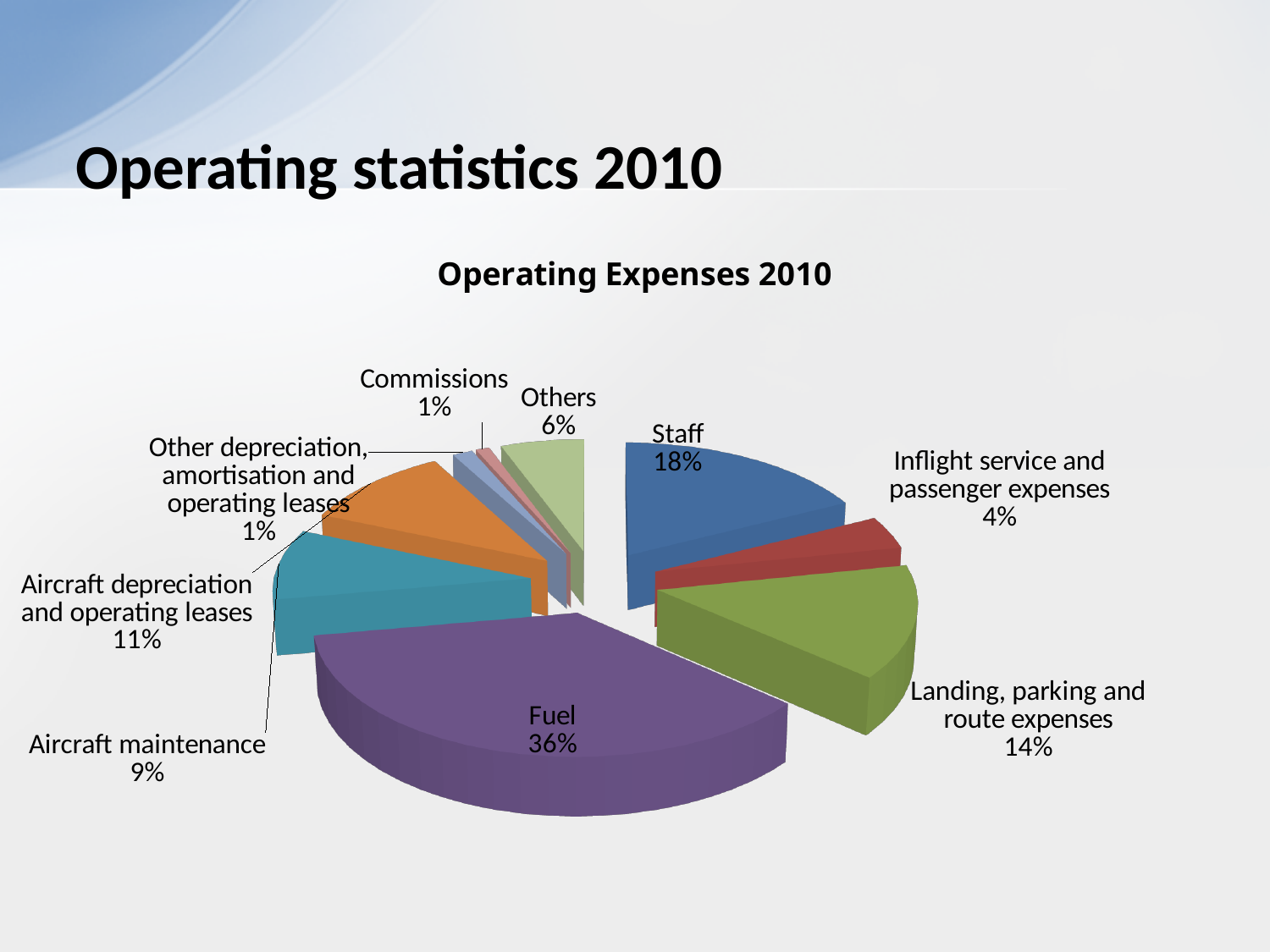
What share of operating expenses is Inflight service and passenger expenses? 4% What kind of chart is shown on the slide? pie chart How many categories are shown in the pie chart? 9 What share of operating expenses is Fuel? 36% What share of operating expenses is Landing, parking and route expenses? 14% What share of operating expenses is Others? 6% What share of operating expenses is Aircraft maintenance? 9% Which is larger, Aircraft depreciation and operating leases or Aircraft maintenance? Aircraft depreciation and operating leases What is the title of the chart? Operating Expenses 2010 What share of operating expenses is Staff? 18% What is the difference in percentage points between Fuel and Staff? 18 Which category has the largest share of operating expenses? Fuel